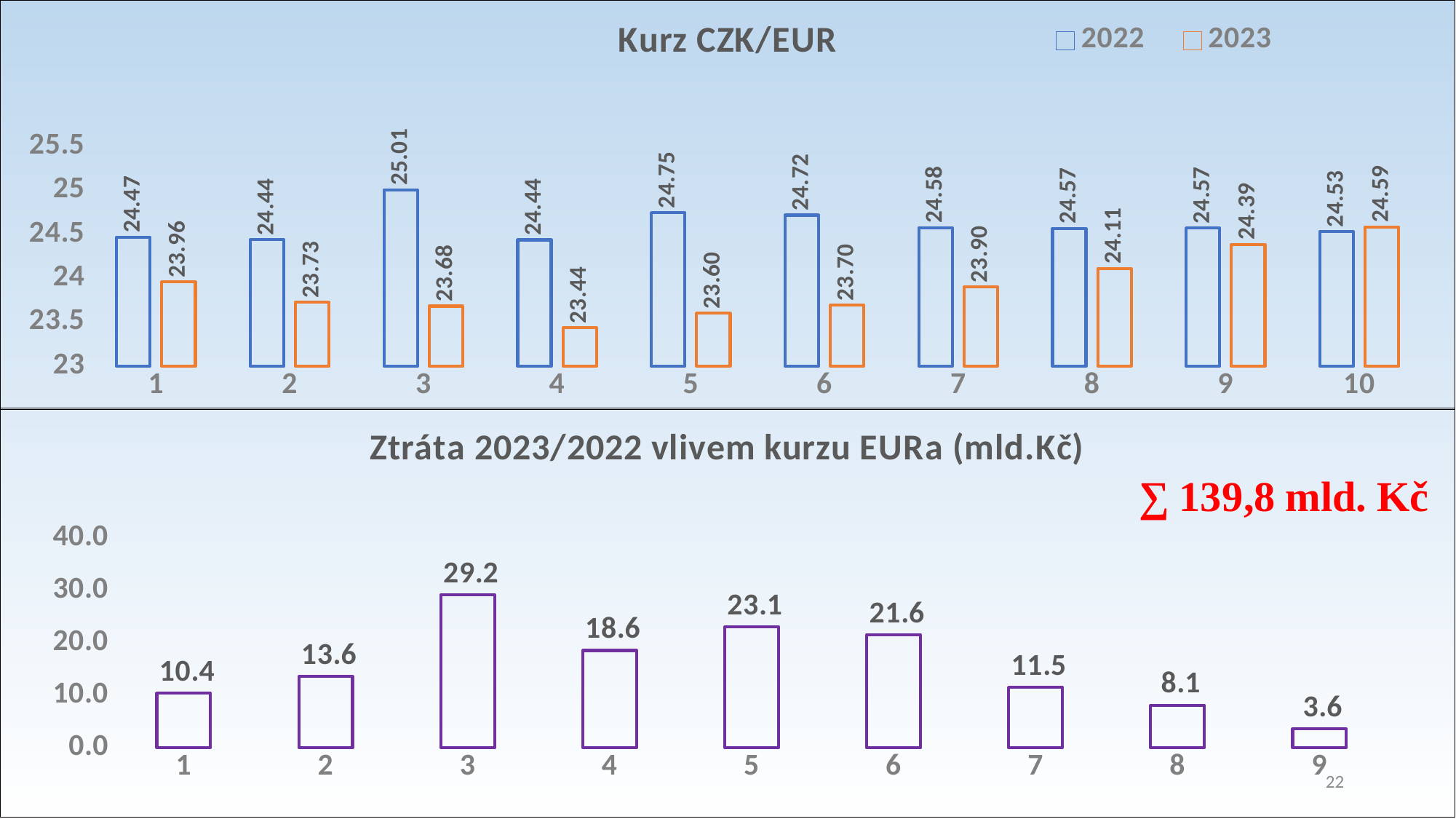
In the 'Ztráta 2023/2022 vlivem kurzu EURa (mld.Kč)' chart, which category has the highest value? 3 How many series does the legend of the 'Kurz CZK/EUR' chart list? 2 In the 'Ztráta 2023/2022 vlivem kurzu EURa (mld.Kč)' chart, what is the difference between the values for category 3 and category 9? 25.6 In the 'Ztráta 2023/2022 vlivem kurzu EURa (mld.Kč)' chart, what is the value for category 5? 23.1 In the 'Kurz CZK/EUR' chart, which category has the lowest 2023 value? 4 In the 'Kurz CZK/EUR' chart, what is the difference between the 2022 and 2023 values for category 1? 0.51 How many categories are shown on the x axis of the 'Kurz CZK/EUR' chart? 10 In the 'Kurz CZK/EUR' chart, what is the 2022 value for category 3? 25.01 In the 'Kurz CZK/EUR' chart, which category has the highest 2022 value? 3 What kind of chart is the 'Ztráta 2023/2022 vlivem kurzu EURa (mld.Kč)' chart? Bar chart In the 'Kurz CZK/EUR' chart, for category 10, which series has the larger value, 2022 or 2023? 2023 In the 'Kurz CZK/EUR' chart, what is the 2023 value for category 4? 23.44